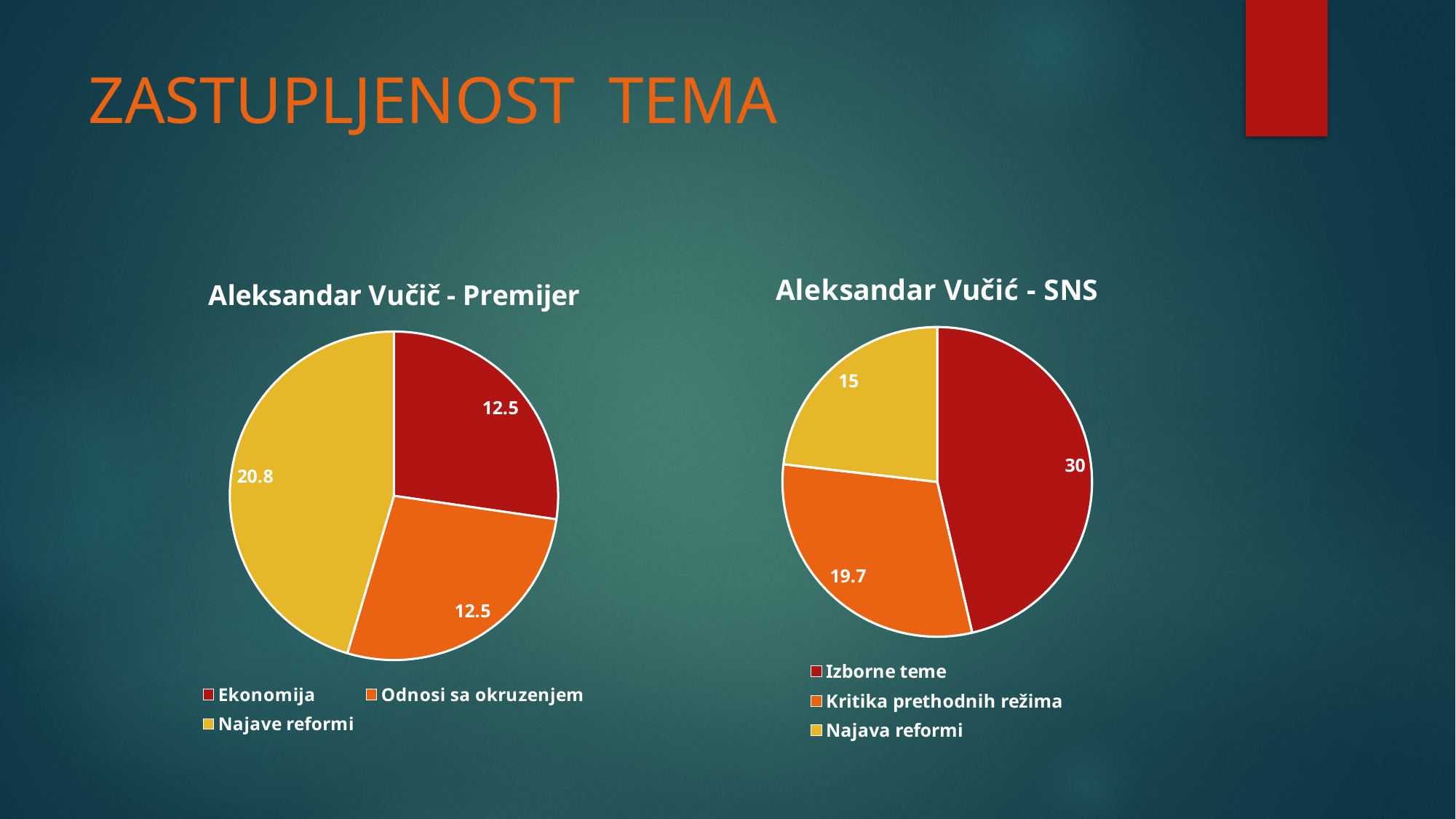
How many categories does the 'Aleksandar Vučić - SNS' chart show? 3 In the 'Aleksandar Vučić - SNS' chart, which is larger, Kritika prethodnih režima or Najava reformi? Kritika prethodnih režima What type of chart is the 'Aleksandar Vučič - Premijer' chart? Pie chart In the 'Aleksandar Vučić - SNS' chart, what is the difference between Izborne teme and Najava reformi? 15 In the 'Aleksandar Vučić - SNS' chart, which category has the smallest slice? Najava reformi In the 'Aleksandar Vučič - Premijer' chart, what is the difference between Najave reformi and Ekonomija? 8.3 In the 'Aleksandar Vučič - Premijer' chart, what is the value for Ekonomija? 12.5 In the 'Aleksandar Vučič - Premijer' chart, which category has the largest slice? Najave reformi In the 'Aleksandar Vučić - SNS' chart, what is the value for Najava reformi? 15 In the 'Aleksandar Vučič - Premijer' chart, what is the value for Najave reformi? 20.8 In the 'Aleksandar Vučić - SNS' chart, what is the value for Kritika prethodnih režima? 19.7 In the 'Aleksandar Vučić - SNS' chart, which category has the largest slice? Izborne teme